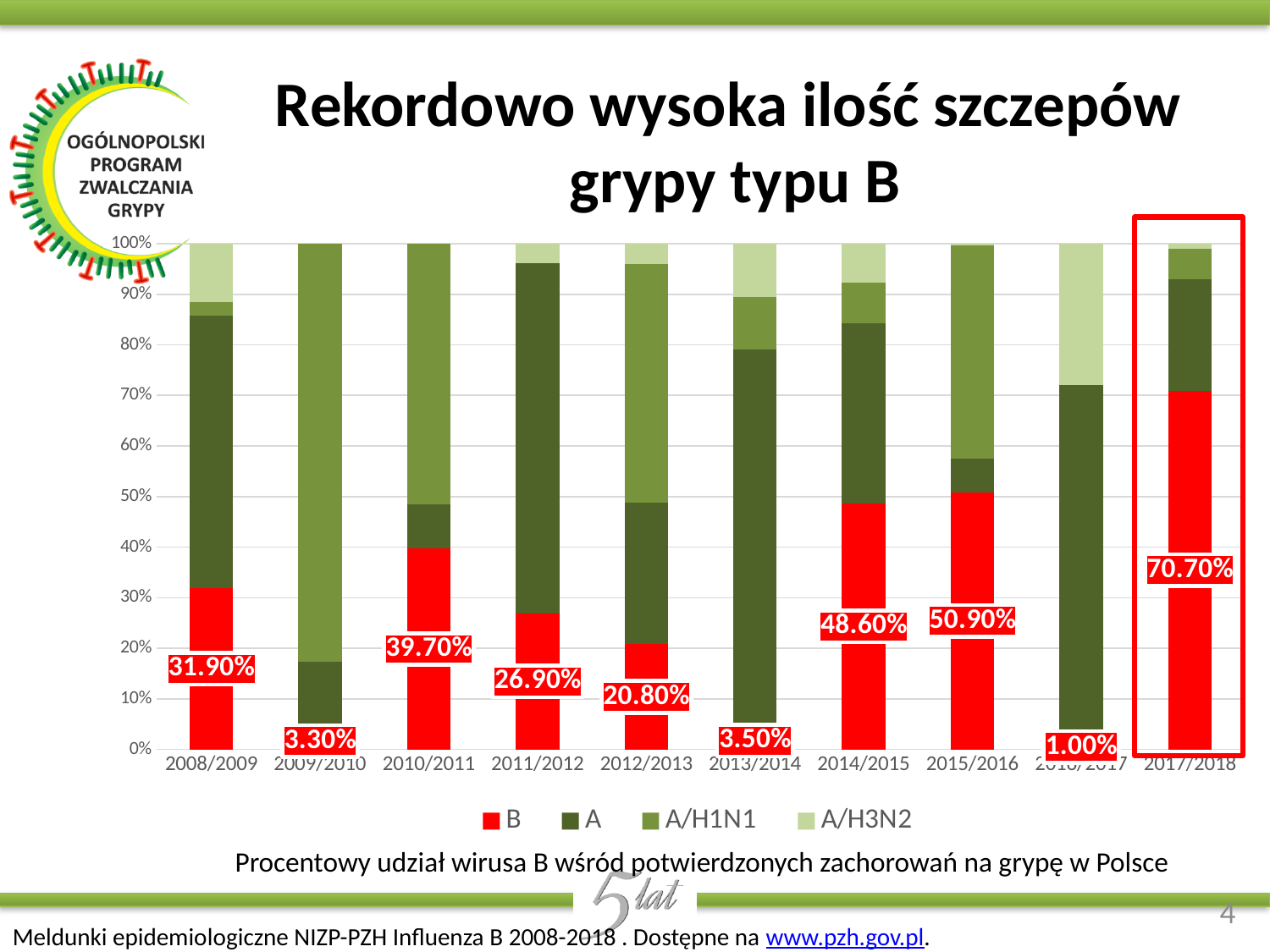
What is the value for B in the 2017/2018 season? 70.70% What is the value for B in the 2016/2017 season? 1.00% Which season has a larger value for B, 2010/2011 or 2011/2012? 2010/2011 What kind of chart is shown on the slide? Stacked bar chart What is the difference between the B values for 2017/2018 and 2015/2016? 19.80% Which season has the highest value for B? 2017/2018 How many seasons are shown on the x axis? 10 What is the value for B in the 2008/2009 season? 31.90% What is the value for B in the 2015/2016 season? 50.90% How many series does the legend list? 4 Is the value for B in 2014/2015 greater or less than 40%? greater Which season has the lowest value for B? 2016/2017